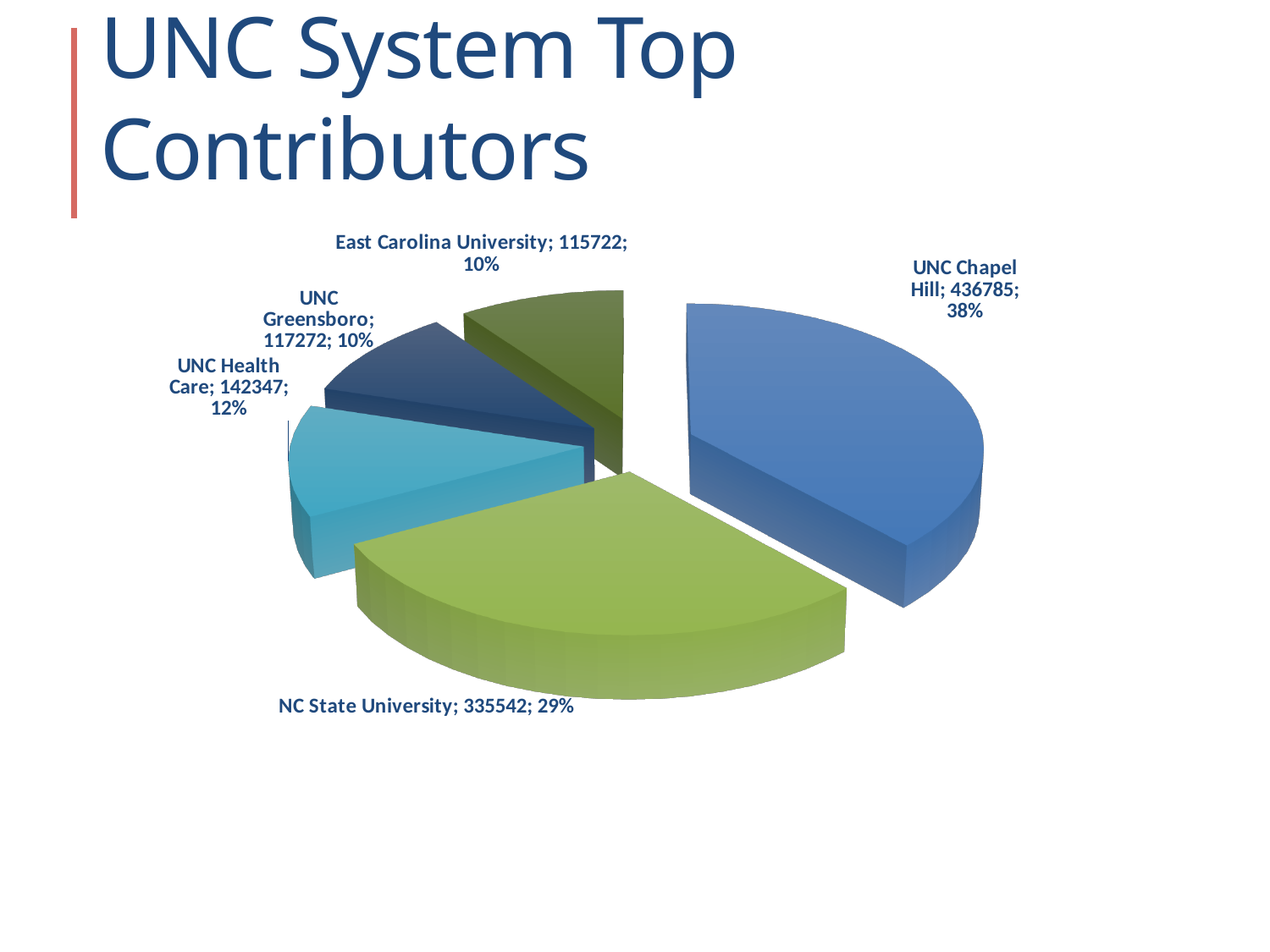
What is the value for UNC Greensboro? 117272 What is the value for East Carolina University? 115722 What is the value for UNC Chapel Hill? 436785 Which contributor has the largest slice? UNC Chapel Hill Which is larger, the value for UNC Health Care or the value for UNC Greensboro? UNC Health Care What kind of chart is shown on the slide? Pie chart What share of the pie does UNC Health Care represent? 12% How many slices does the pie chart have? 5 What is the difference between the values for UNC Chapel Hill and NC State University? 101243 What is the value for NC State University? 335542 What share of the pie does NC State University represent? 29% What is the value for UNC Health Care? 142347